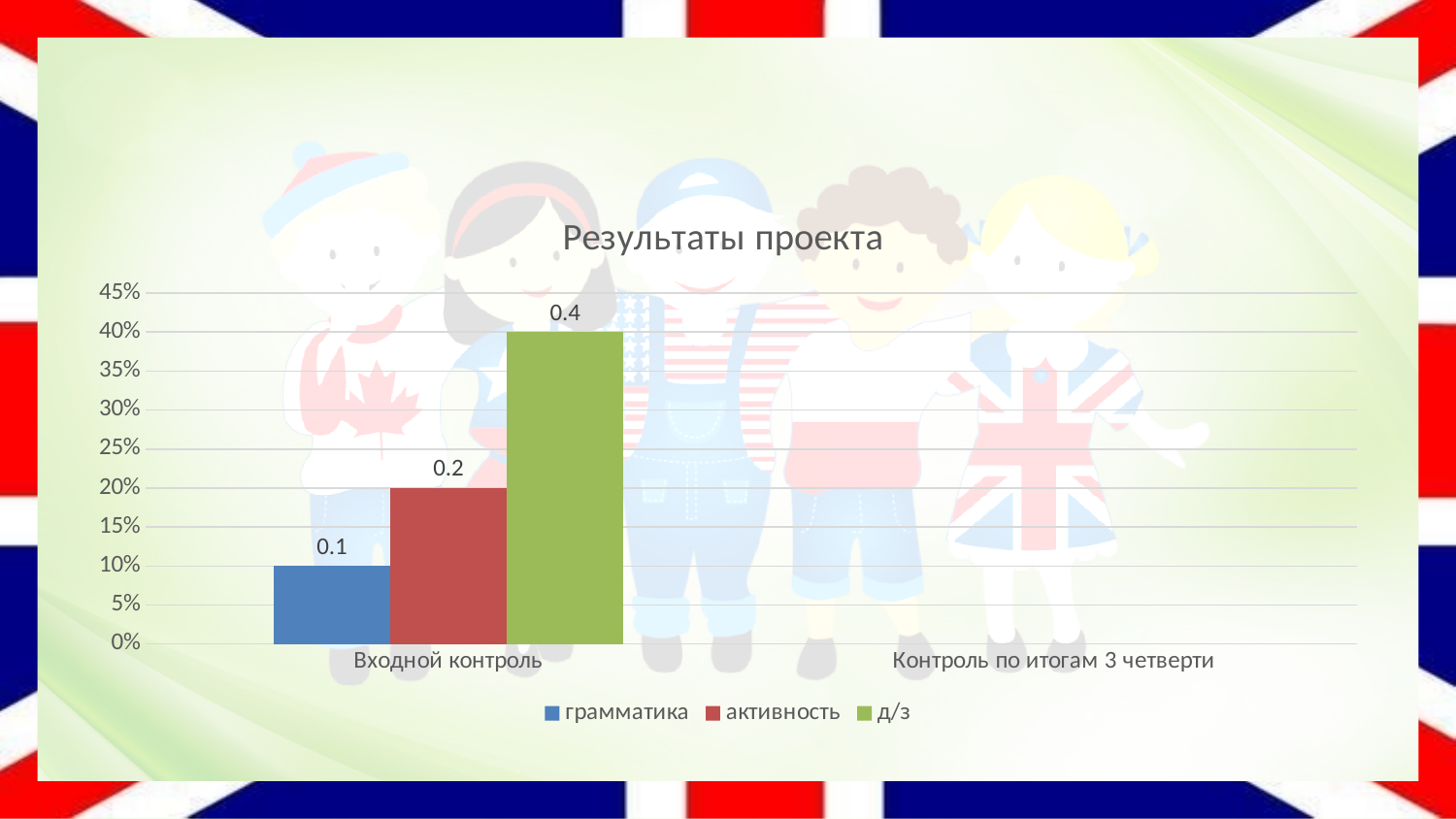
How many series does the legend list? 3 What type of chart is shown on the slide? bar chart Is the д/з bar in the Входной контроль category greater or less than 30%? greater Which series has the highest value in the Входной контроль category? д/з How many categories are shown on the x axis? 2 What is the value for грамматика in the Входной контроль category? 0.1 What is the value for активность in the Входной контроль category? 0.2 What is the difference between the д/з value and the грамматика value in the Входной контроль category? 0.3 Which series has the lowest value in the Входной контроль category? грамматика What is the difference between the д/з value and the активность value in the Входной контроль category? 0.2 In the Входной контроль category, which is larger: активность or грамматика? активность What is the value for д/з in the Входной контроль category? 0.4